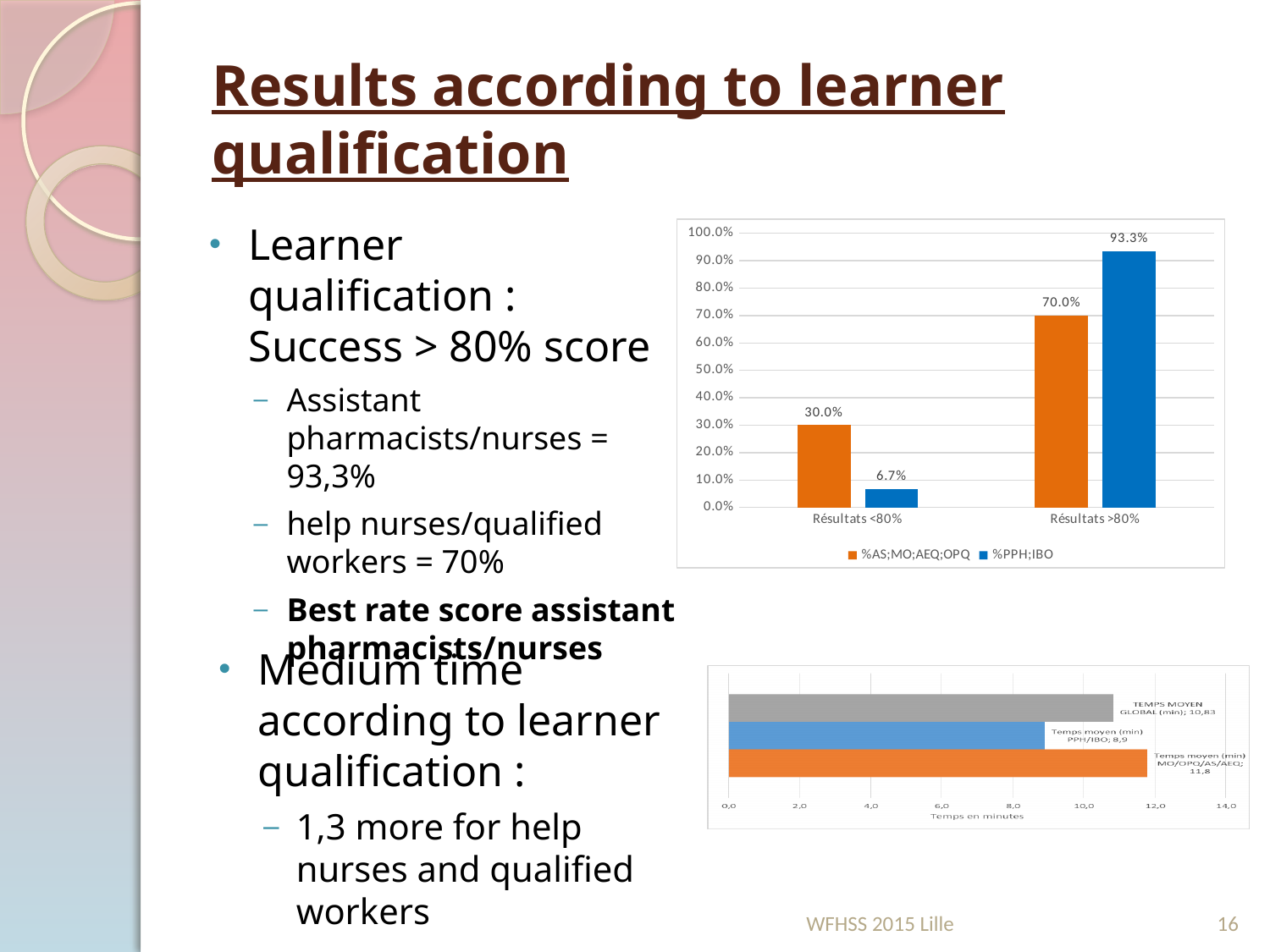
In the top chart, what is the value of %PPH;IBO for Résultats >80%? 93.3% In the top chart, how many categories are shown on the x axis? 2 In the bottom chart, what is the value for TEMPS MOYEN GLOBAL (min)? 10,83 In the top chart, what is the value of %AS;MO;AEQ;OPQ for Résultats <80%? 30.0% In the top chart, what is the difference between the %PPH;IBO and %AS;MO;AEQ;OPQ values for Résultats >80%? 23.3% In the top chart, how many series does the legend list? 2 In the top chart, what is the value of %AS;MO;AEQ;OPQ for Résultats >80%? 70.0% What kind of chart is the top chart? Bar chart In the top chart, which series has the larger value for Résultats <80%? %AS;MO;AEQ;OPQ In the top chart, what is the value of %PPH;IBO for Résultats <80%? 6.7% In the bottom chart, which category has the highest value? Temps moyen (min) MO/OPQ/AS/AEQ In the bottom chart, what is the value for Temps moyen (min) PPH/IBO? 8,9